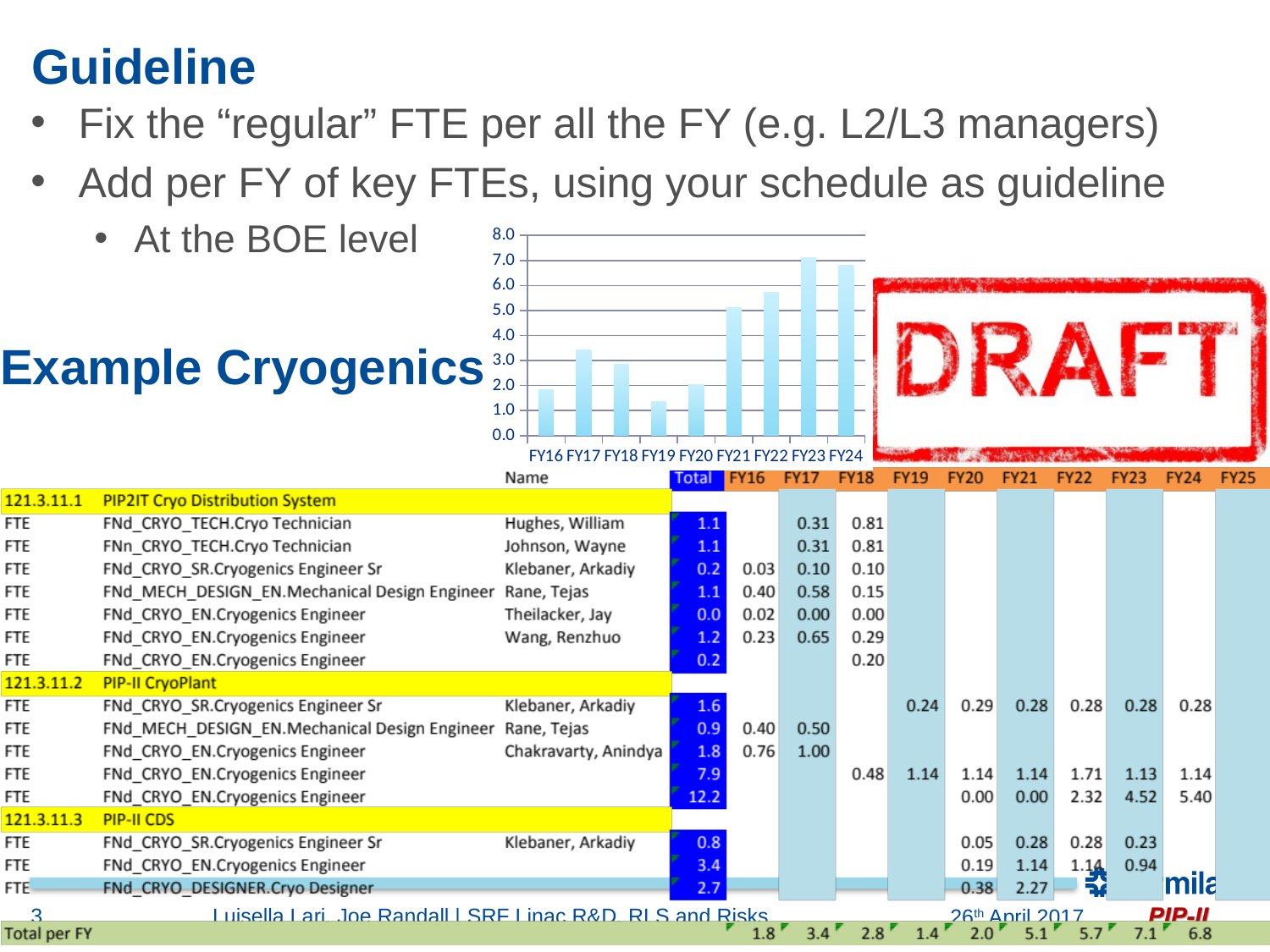
Is the value for FY16 greater or less than 2.0? less Which bar is taller, FY21 or FY22? FY22 Which fiscal year has the shortest bar in the chart? FY19 Do the bar values rise or fall from FY20 to FY23? rise Which fiscal year has the tallest bar in the chart? FY23 Is the value for FY21 greater or less than 4.0? greater Which bar is taller, FY17 or FY18? FY17 What is the highest tick value shown on the chart's y axis? 8.0 Is the value for FY23 greater or less than 6.0? greater How many fiscal years are plotted on the x axis of the chart? 9 What kind of chart is shown on the slide? bar chart